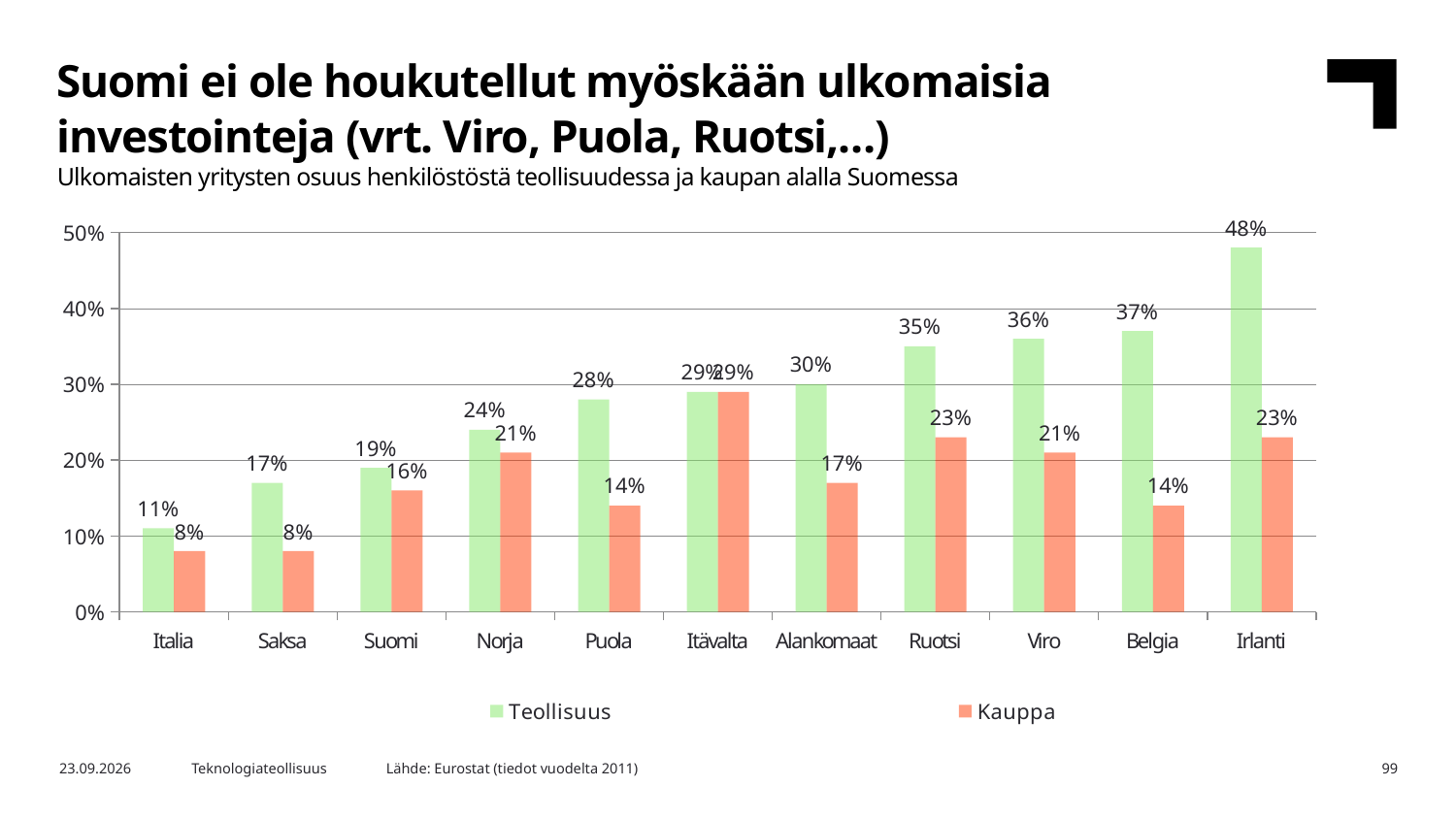
What is the Teollisuus value for Suomi? 19% Which country has the lowest Teollisuus value? Italia Is the Teollisuus value for Viro greater or less than 30%? greater What is the difference between the Teollisuus values for Irlanti and Suomi? 29% Which series is shown in green in the legend? Teollisuus How many series does the legend list? 2 Do the Teollisuus values rise or fall from Italia to Irlanti along the x axis? Rise How many countries are shown on the x axis? 11 Which country has the highest Teollisuus value? Irlanti Which is larger, the Kauppa value for Norja or the Kauppa value for Puola? Norja What kind of chart is shown on the slide? Bar chart What is the Kauppa value for Ruotsi? 23%